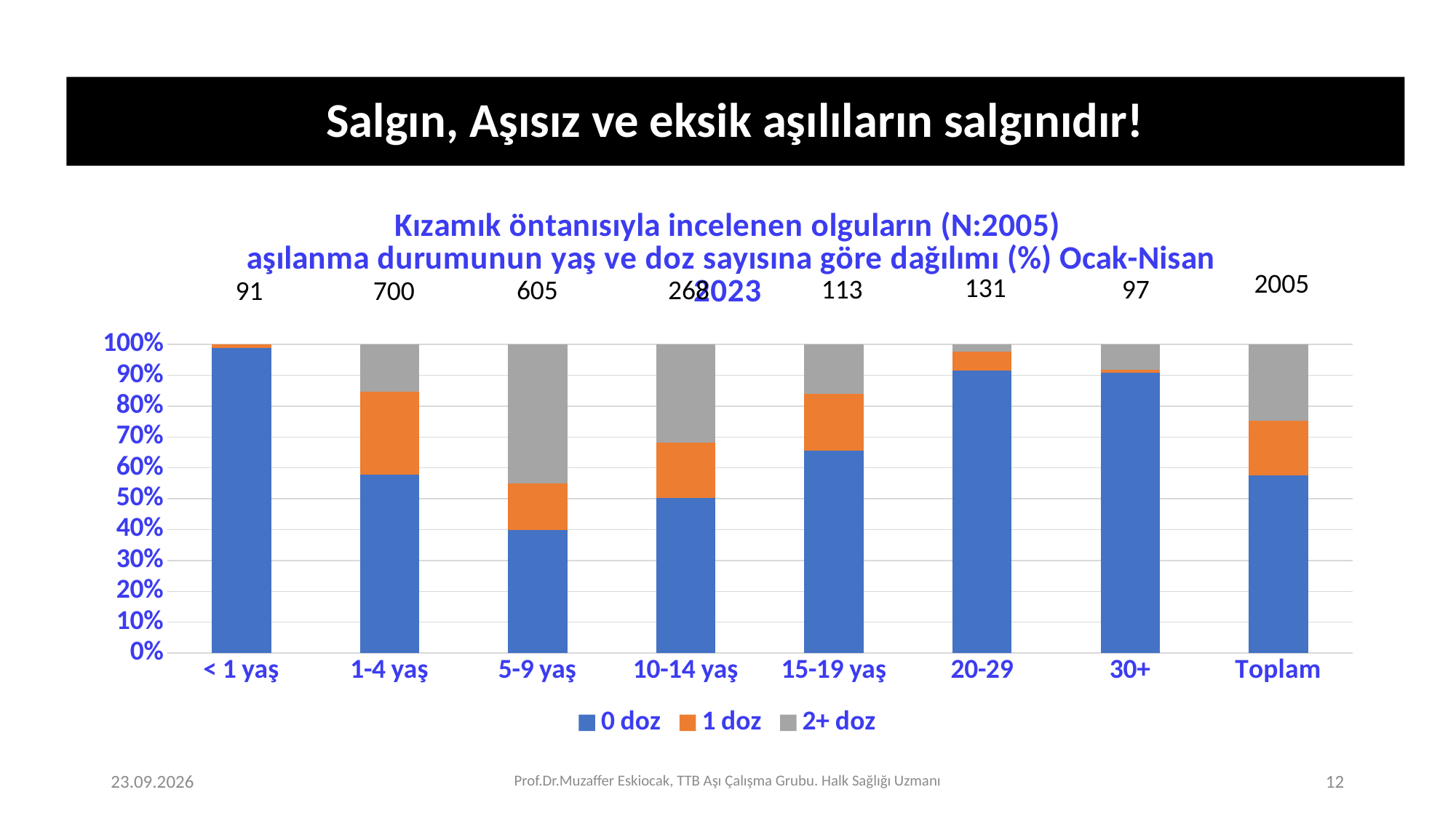
Which age category has the lowest share of 0 doz? 5-9 yaş What kind of chart is shown on the slide? stacked bar chart How many age categories are shown on the x axis of the chart? 7 Is the 0 doz share for 5-9 yaş greater or less than 50%? less What are the three series named in the legend? 0 doz, 1 doz, 2+ doz Which has a larger 0 doz share, 1-4 yaş or 5-9 yaş? 1-4 yaş What number is printed above the Toplam bar? 2005 How many series does the chart's legend list? 3 Which age category has the highest share of 0 doz? < 1 yaş What number is printed above the 1-4 yaş bar? 700 Is the 0 doz share for 15-19 yaş greater or less than 60%? greater Is the 0 doz share for 20-29 greater or less than 80%? greater